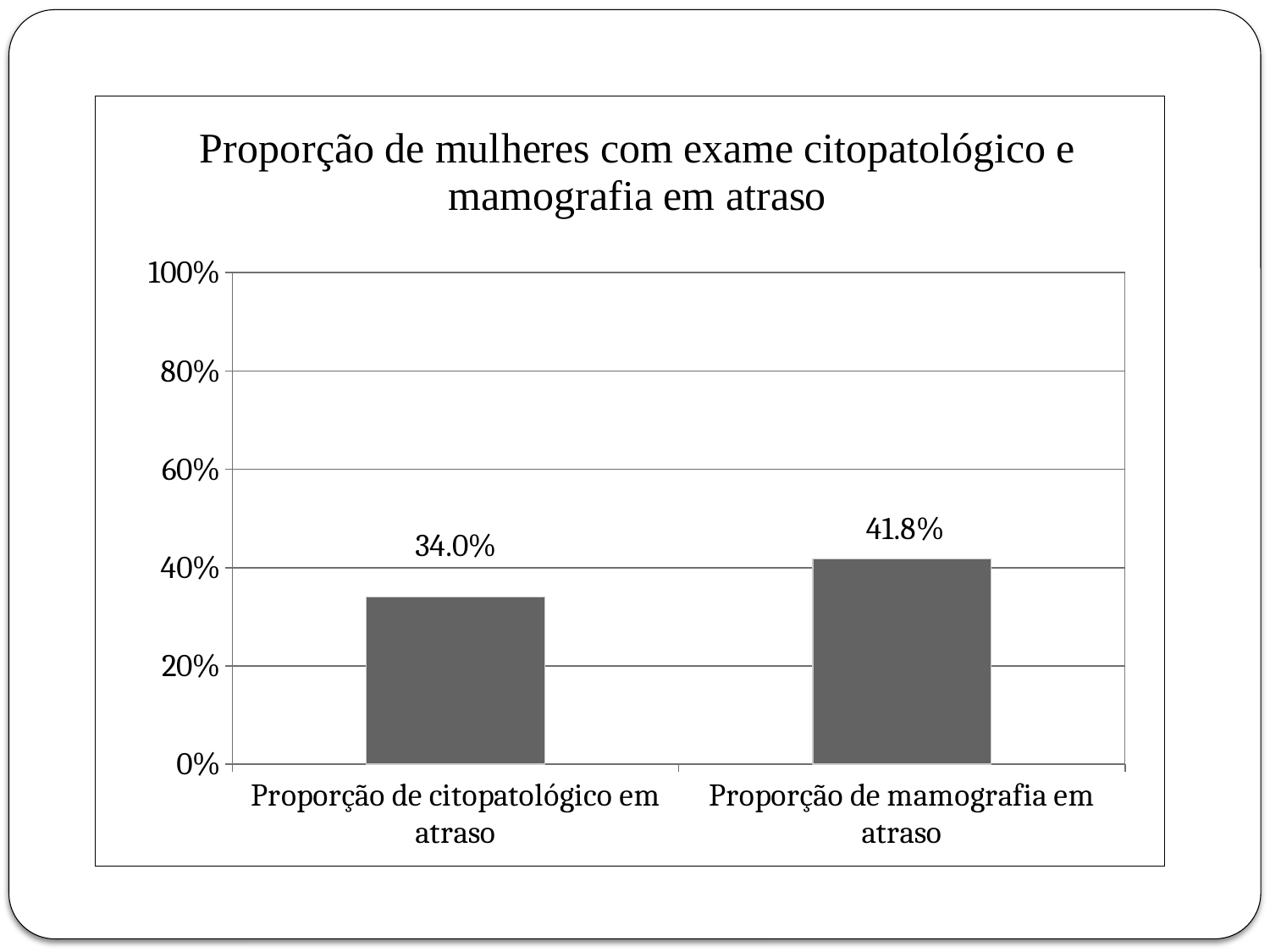
Is the value for 'Proporção de citopatológico em atraso' greater or less than 40%? less Is the value for 'Proporção de mamografia em atraso' greater or less than 40%? greater What is the maximum value shown on the vertical axis? 100% Which is larger: the value for 'Proporção de citopatológico em atraso' or the value for 'Proporção de mamografia em atraso'? Proporção de mamografia em atraso What is the title of the chart? Proporção de mulheres com exame citopatológico e mamografia em atraso Which category has the highest value? Proporção de mamografia em atraso What is the difference between the value for 'Proporção de mamografia em atraso' and the value for 'Proporção de citopatológico em atraso'? 7.8% What kind of chart is shown on the slide? bar chart Which category has the lowest value? Proporção de citopatológico em atraso How many categories are shown in the chart? 2 What is the value for 'Proporção de citopatológico em atraso'? 34.0% What is the value for 'Proporção de mamografia em atraso'? 41.8%